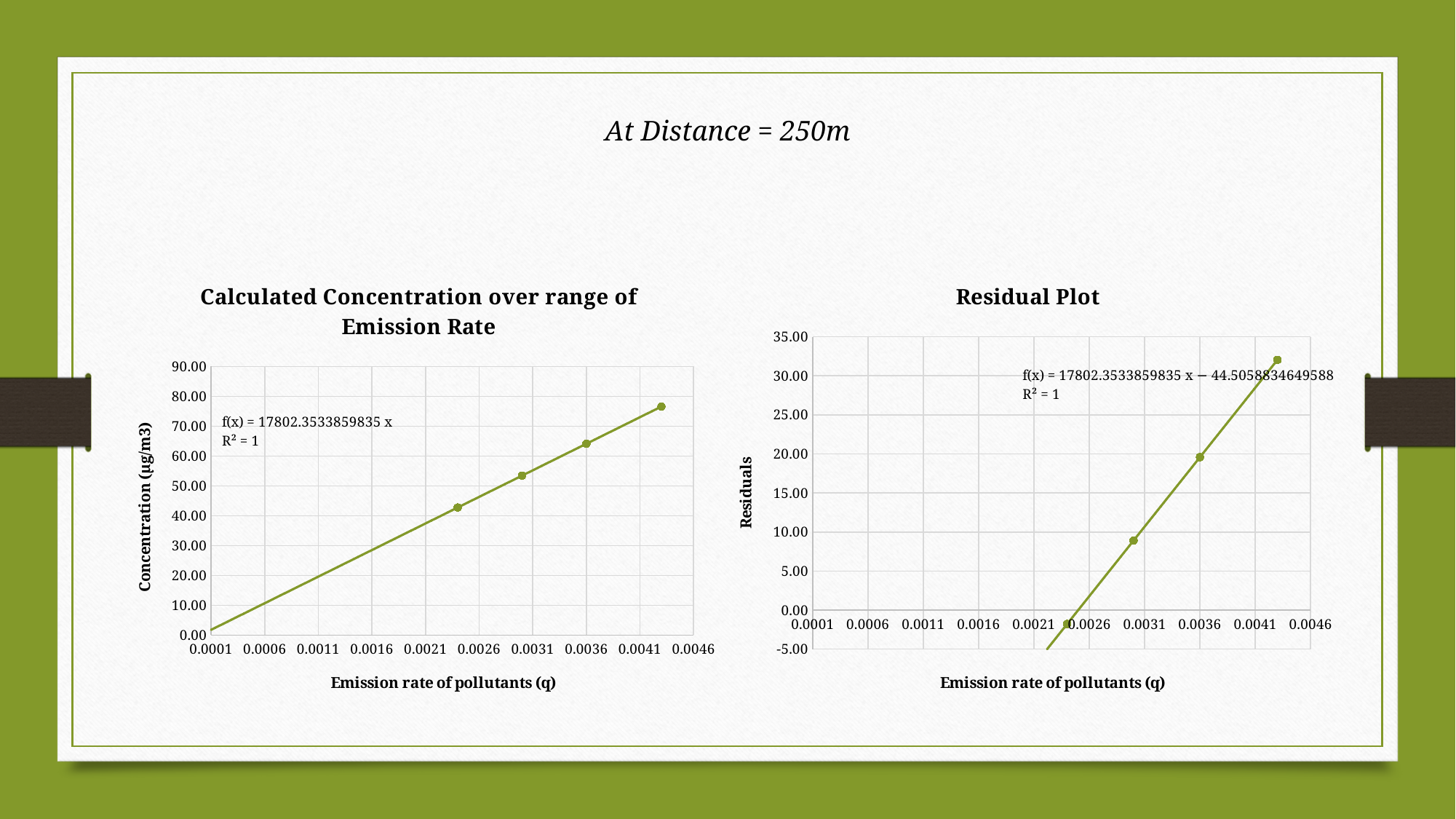
What R² value is shown on the 'Residual Plot' chart? R² = 1 On the 'Residual Plot' chart, is the residual of the lowest plotted point greater or less than 0.00? less How many data points are plotted on the 'Residual Plot' chart? 4 On the 'Calculated Concentration over range of Emission Rate' chart, is the concentration of the lowest plotted point greater or less than 50.00? less How many data points are plotted on the 'Calculated Concentration over range of Emission Rate' chart? 5 On the 'Residual Plot' chart, is the residual of the highest plotted point greater or less than 30.00? greater What kind of chart is the 'Calculated Concentration over range of Emission Rate' chart? scatter chart with a trendline On the 'Calculated Concentration over range of Emission Rate' chart, do the concentration values rise or fall as the emission rate increases? rise What is the y-axis label of the 'Calculated Concentration over range of Emission Rate' chart? Concentration (µg/m3) On the 'Residual Plot' chart, do the residuals rise or fall as the emission rate increases? rise